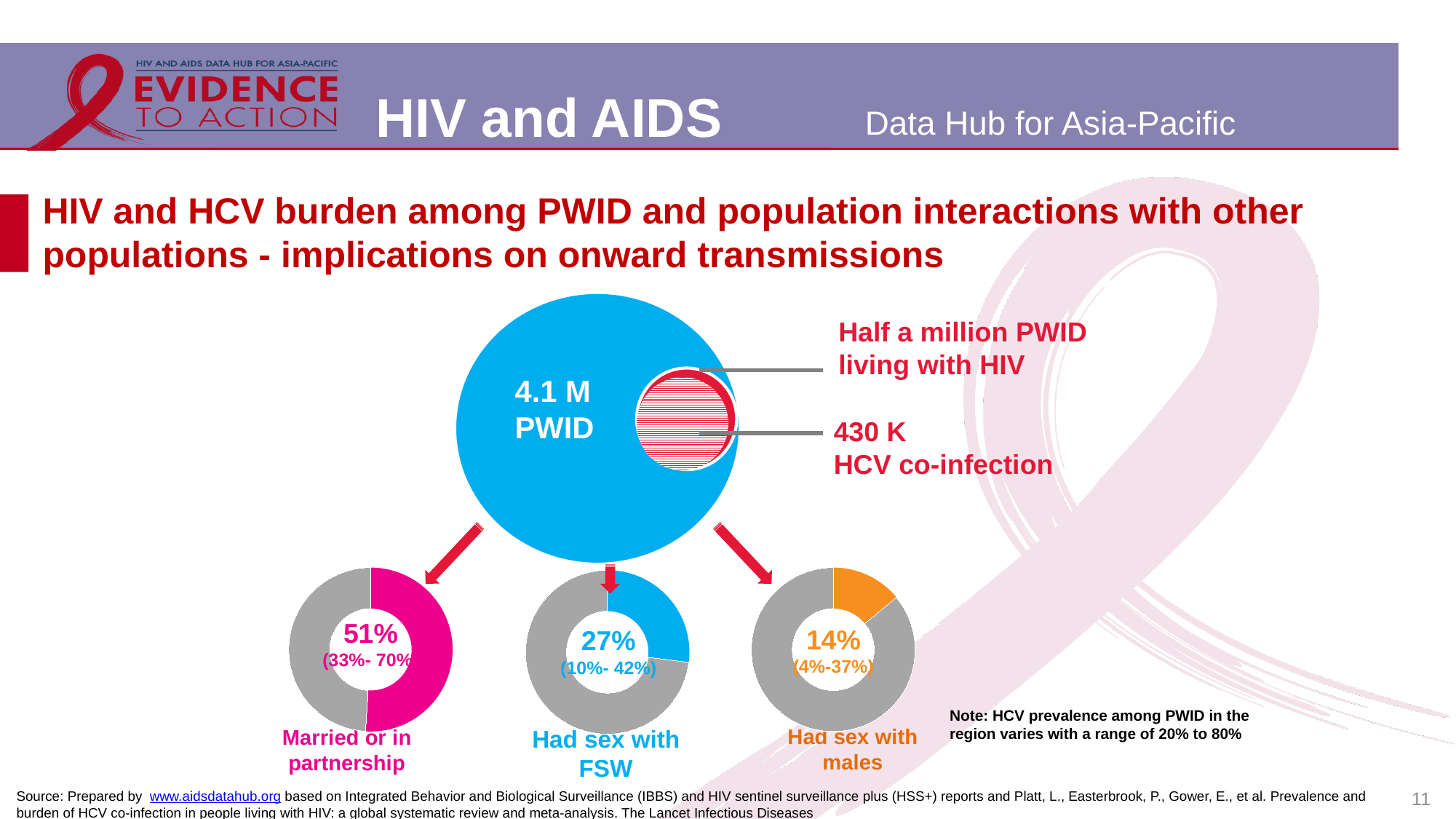
What kind of chart is used to show the 51%, 27% and 14% values? Donut chart In the 'Married or in partnership' donut chart, what percentage is shown? 51% How many donut charts are shown at the bottom of the slide? 3 In the 'Had sex with males' donut chart, what percentage is shown? 14% In the large circle graphic, how many PWID are shown in total? 4.1 M What is the difference between the percentage in the 'Married or in partnership' donut chart and the 'Had sex with FSW' donut chart? 24% Which is larger: the percentage in the 'Had sex with FSW' donut chart or the 'Had sex with males' donut chart? Had sex with FSW In the 'Had sex with FSW' donut chart, what percentage is shown? 27% What range is printed below the 51% value in the 'Married or in partnership' donut chart? 33%- 70% What range is printed below the 14% value in the 'Had sex with males' donut chart? 4%-37% Which of the three donut charts shows the lowest percentage? Had sex with males Which of the three donut charts shows the highest percentage? Married or in partnership